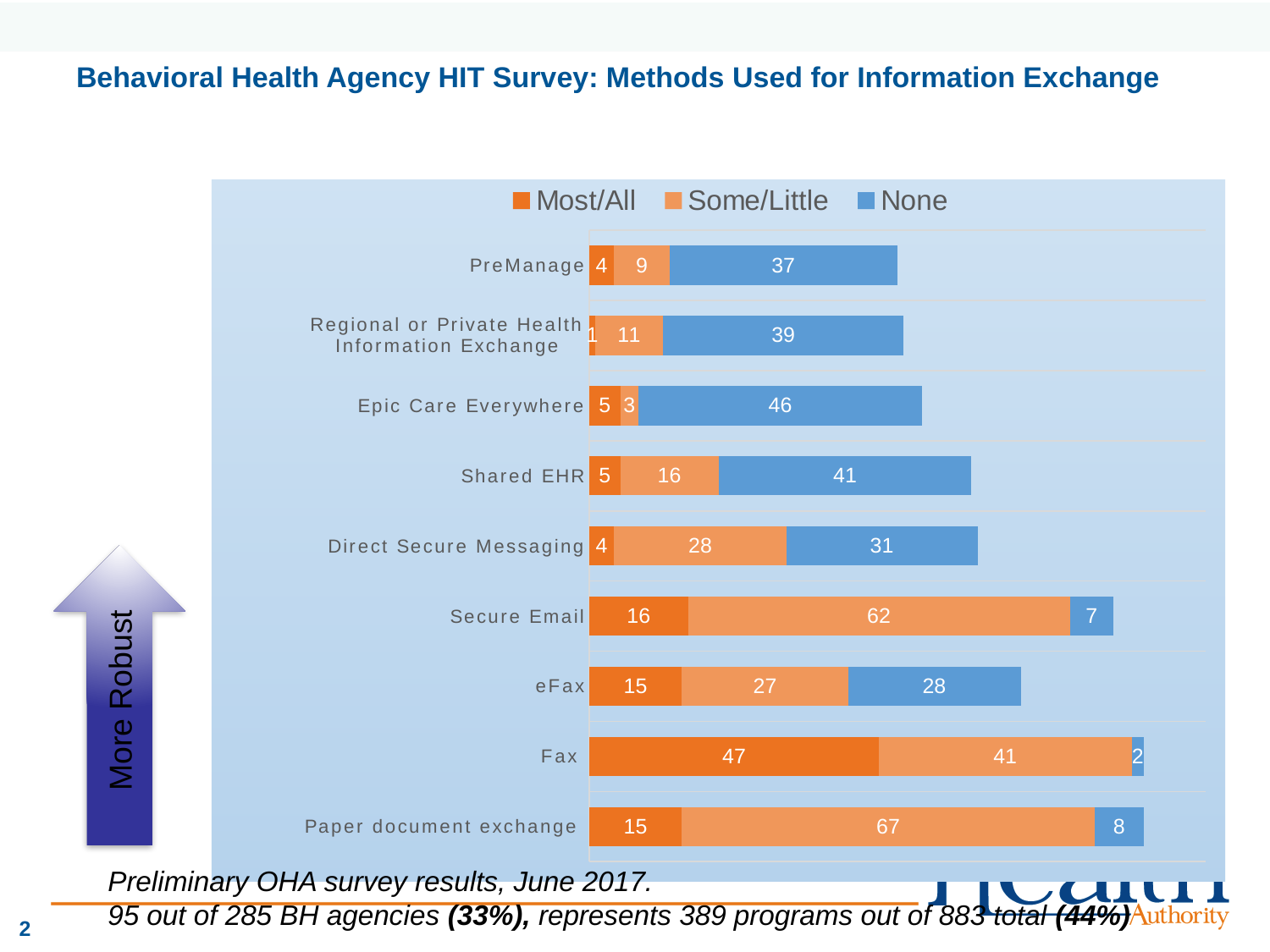
Which series is shown in the darkest orange colour in the legend? Most/All Which method has the lowest None value? Fax What is the total of the stacked bar for Direct Secure Messaging? 63 How many series does the legend list? 3 What is the Most/All value for Fax? 47 Which method has the highest Most/All value? Fax How many methods (categories) are plotted in the chart? 9 Which is larger: the None value for Shared EHR or the None value for PreManage? Shared EHR What is the Some/Little value for Paper document exchange? 67 What kind of chart is shown on the slide? Stacked bar chart What is the difference between the Some/Little values for Secure Email and eFax? 35 What is the None value for Epic Care Everywhere? 46